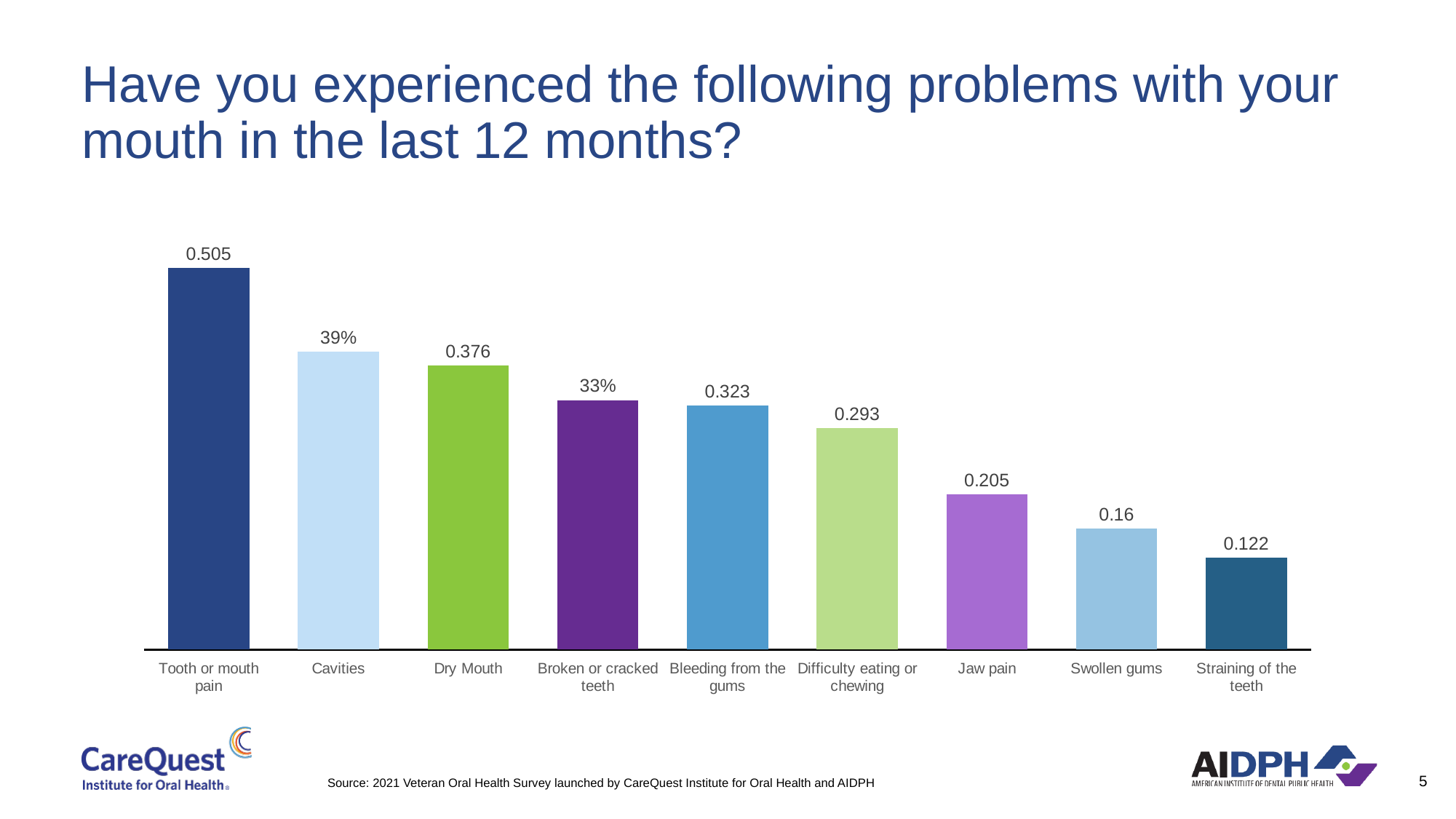
What is the value for Straining of the teeth? 0.122 What is the difference between the values for Tooth or mouth pain and Dry Mouth? 0.129 Which is larger, the value for Bleeding from the gums or the value for Difficulty eating or chewing? Bleeding from the gums Which category has the lowest value? Straining of the teeth What is the value for Jaw pain? 0.205 What is the value for Tooth or mouth pain? 0.505 Which category has the highest value? Tooth or mouth pain What is the value for Broken or cracked teeth? 33% How many categories are shown in the chart? 9 What is the value for Cavities? 39% Do the values rise or fall from left to right across the categories? fall What is the value for Dry Mouth? 0.376